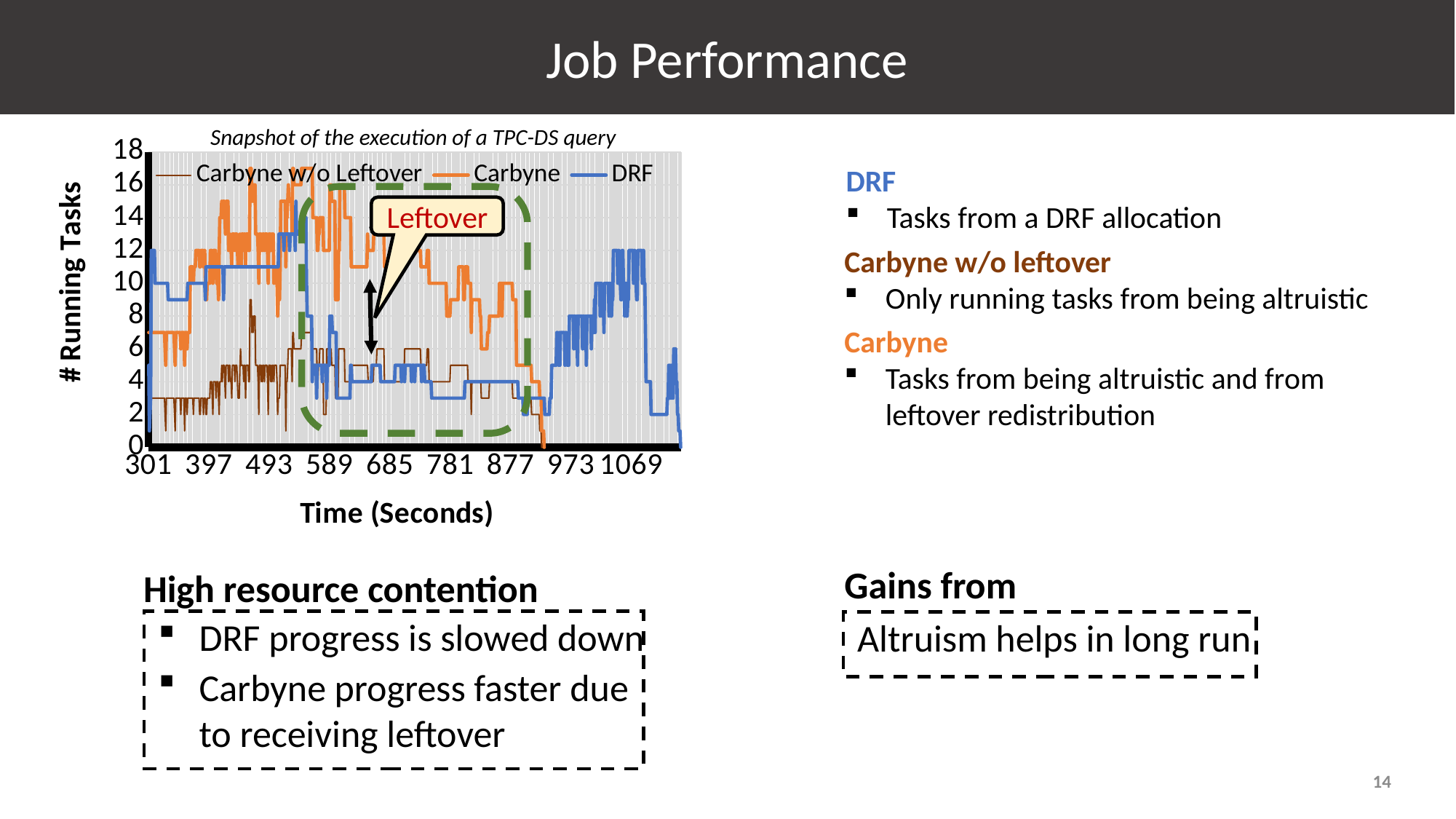
How many series does the chart legend list? 3 At time 685, which series has more running tasks, Carbyne or DRF? Carbyne Is the value of the Carbyne series at time 589 greater or less than 10? greater How many tick labels are shown on the x axis of the chart? 9 Between times 589 and 877, which series has the highest number of running tasks? Carbyne Is the value of the DRF series at time 685 greater or less than 8? less What is the highest value shown on the y axis of the chart? 18 What kind of chart is shown on the slide? line chart What is the label of the chart's x axis? Time (Seconds) What are the three series listed in the chart legend? Carbyne w/o Leftover, Carbyne, DRF What is the label of the chart's y axis? # Running Tasks What is the title of the chart? Snapshot of the execution of a TPC-DS query